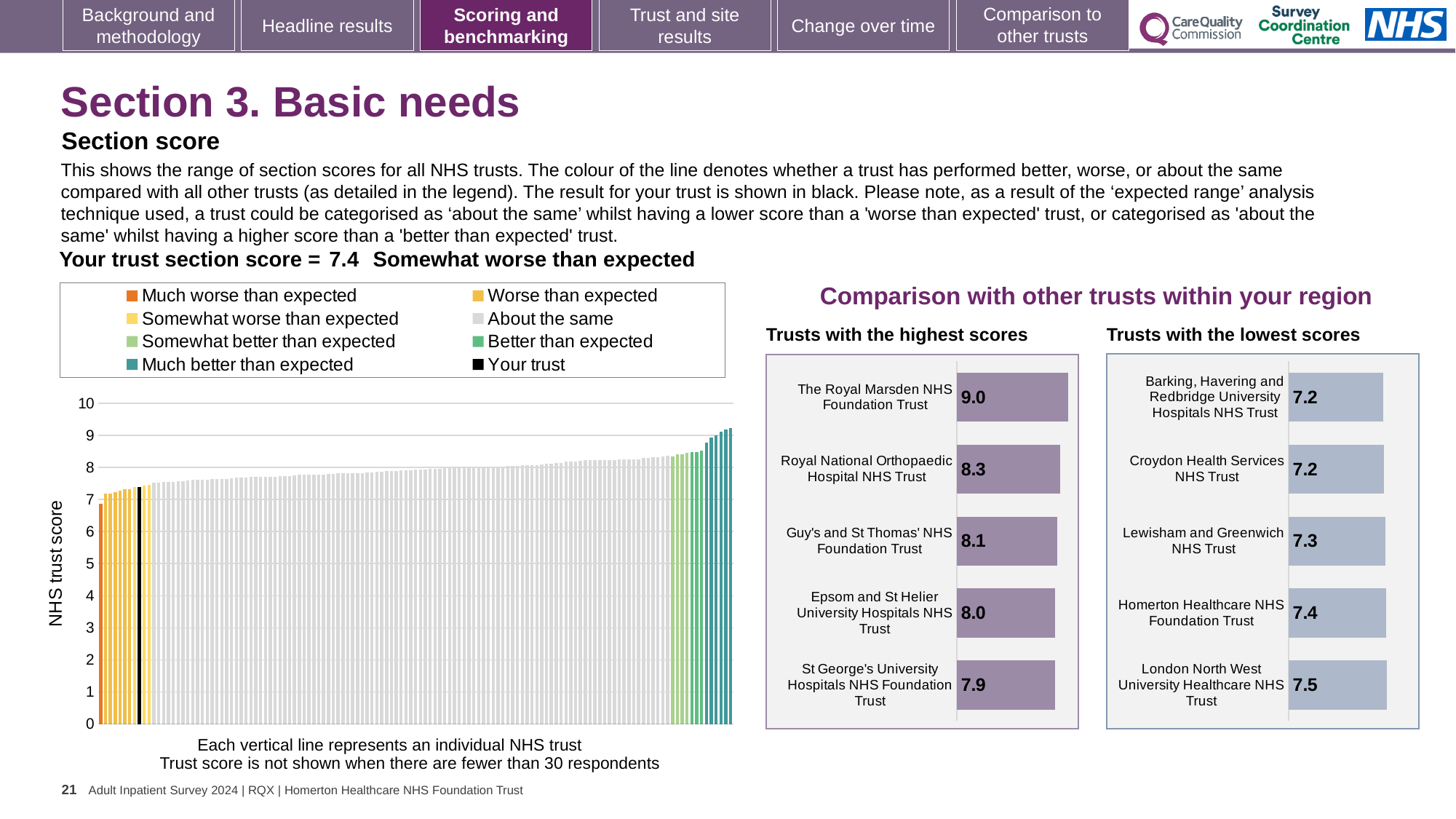
How many entries does the legend of the left-hand NHS trust score chart list? 8 What is the title of the comparison section on the right of the slide? Comparison with other trusts within your region How many trusts are shown in the 'Trusts with the highest scores' chart? 5 In the 'Trusts with the highest scores' chart, which has the higher score: Guy's and St Thomas' NHS Foundation Trust or Epsom and St Helier University Hospitals NHS Trust? Guy's and St Thomas' NHS Foundation Trust In the 'Trusts with the lowest scores' chart, which trust has the highest score? London North West University Healthcare NHS Trust In the 'Trusts with the highest scores' chart, which trust has the highest score? The Royal Marsden NHS Foundation Trust In the 'Trusts with the highest scores' chart, what is the score for The Royal Marsden NHS Foundation Trust? 9.0 In the 'Trusts with the lowest scores' chart, what is the score for Lewisham and Greenwich NHS Trust? 7.3 In the 'Trusts with the lowest scores' chart, what is the difference between the scores of London North West University Healthcare NHS Trust and Croydon Health Services NHS Trust? 0.3 According to the slide, what is your trust's section score for Basic needs? 7.4 What kind of chart is the large chart on the left showing NHS trust scores? Bar chart In the 'Trusts with the highest scores' chart, what is the difference between the scores of The Royal Marsden NHS Foundation Trust and St George's University Hospitals NHS Foundation Trust? 1.1